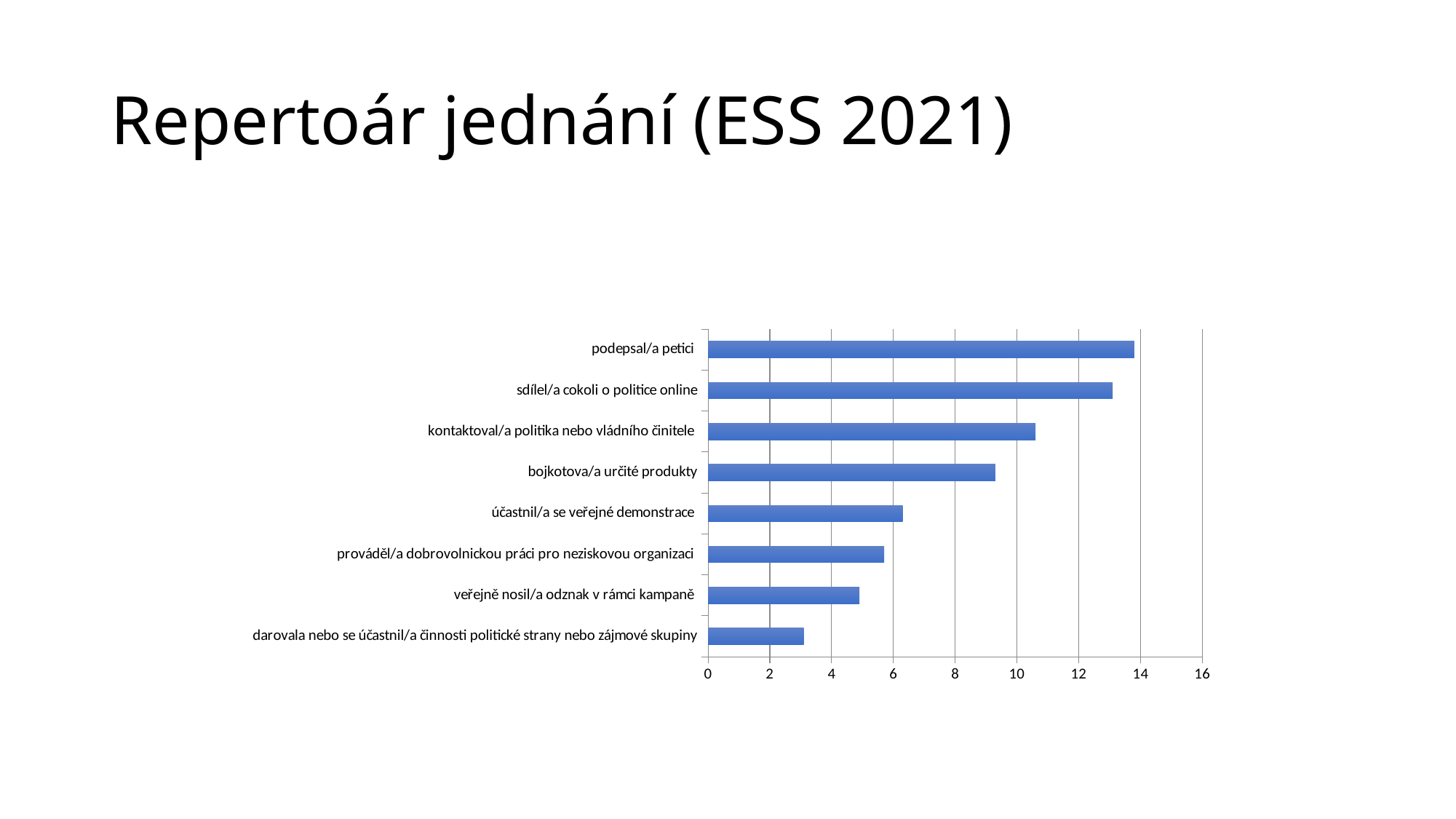
What is the title of the slide containing the chart? Repertoár jednání (ESS 2021) Which activity has the highest value in the chart? podepsal/a petici Is the value for 'bojkotova/a určité produkty' greater or less than 10? less Which is larger: the value for 'kontaktoval/a politika nebo vládního činitele' or for 'bojkotova/a určité produkty'? kontaktoval/a politika nebo vládního činitele Is the value for 'darovala nebo se účastnil/a činnosti politické strany nebo zájmové skupiny' greater or less than 4? less Is the value for 'účastnil/a se veřejné demonstrace' greater or less than 8? less What kind of chart is shown on the slide? bar chart How many categories (activities) are plotted in the chart? 8 Which activity has the lowest value in the chart? darovala nebo se účastnil/a činnosti politické strany nebo zájmové skupiny